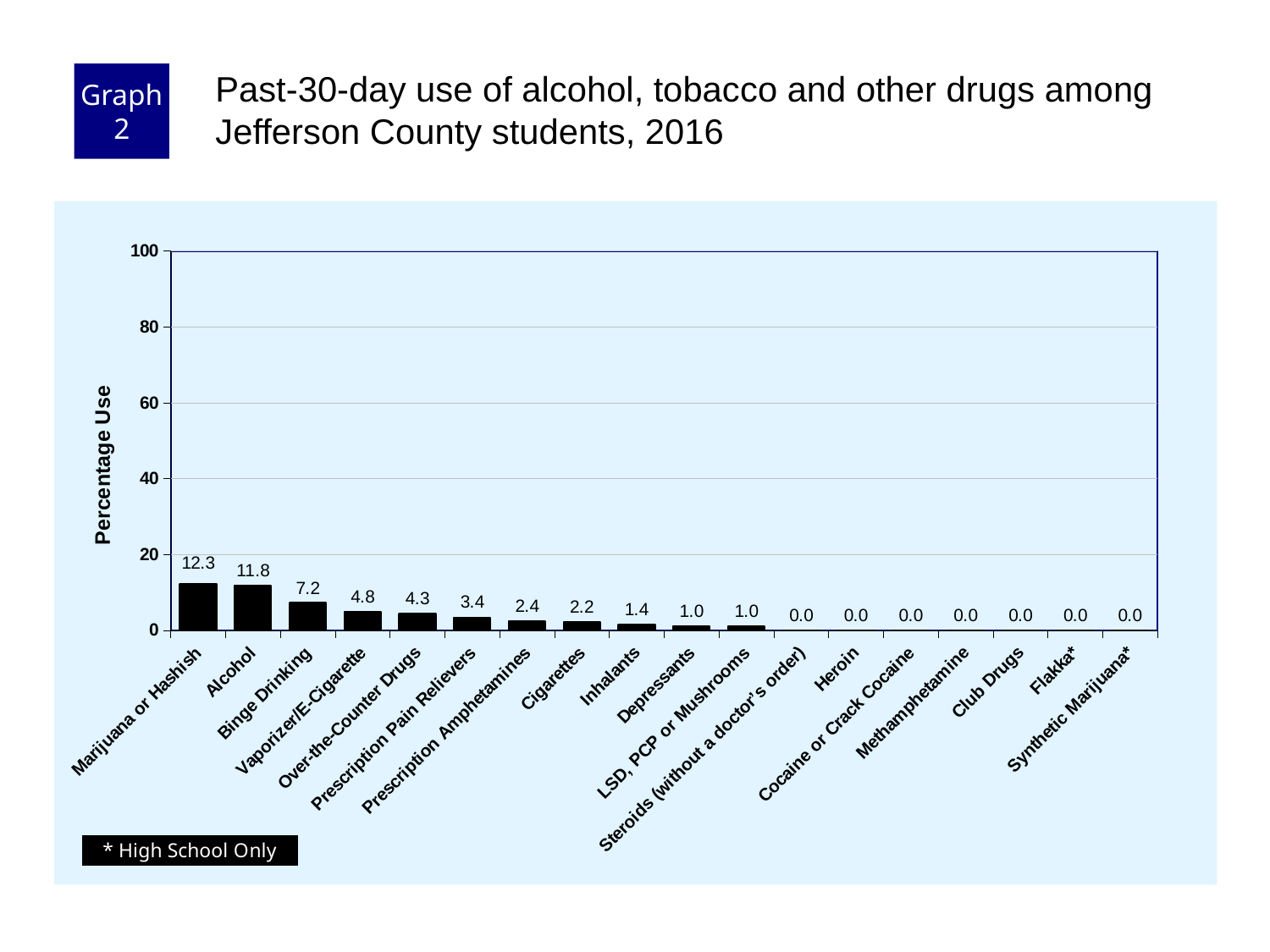
Is the value for Binge Drinking greater or less than 20? less What is the percentage use for Cigarettes? 2.2 What is the percentage use for Vaporizer/E-Cigarette? 4.8 Which has a higher percentage use, Prescription Pain Relievers or Inhalants? Prescription Pain Relievers What is the percentage use for Alcohol? 11.8 How many categories are shown on the x axis? 18 What type of chart is shown on the slide? Bar chart Which category has the highest percentage use? Marijuana or Hashish What is the percentage use for Marijuana or Hashish? 12.3 What is the difference in percentage use between Marijuana or Hashish and Alcohol? 0.5 What is the difference in percentage use between Binge Drinking and Over-the-Counter Drugs? 2.9 How many categories have a value of 0.0? 7